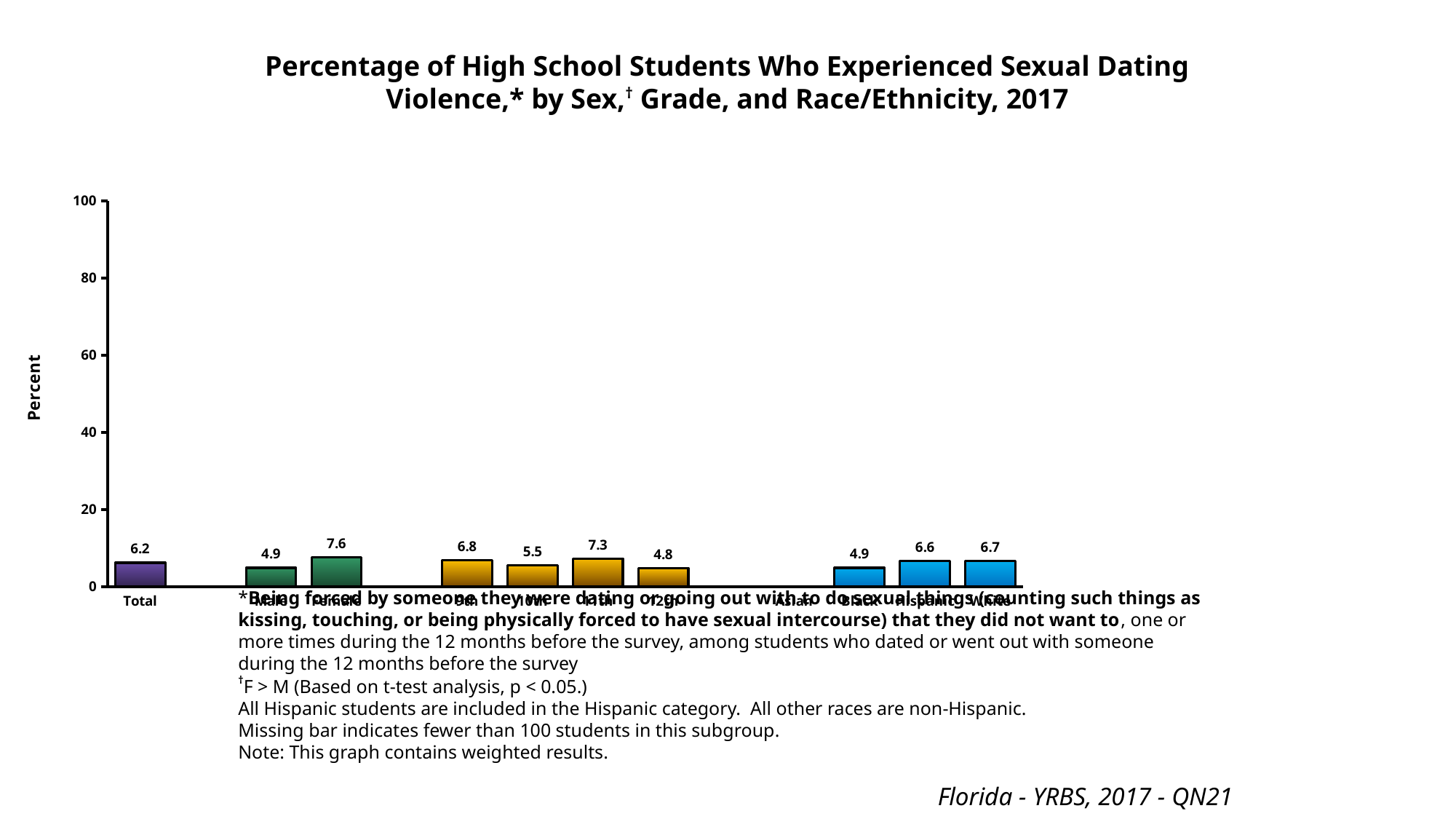
What is the highest value labelled on any bar in the chart? 7.6 What is the lowest value labelled on any bar in the chart? 4.8 What kind of chart is shown on the slide? bar chart What is the label on the vertical axis? Percent What is the difference between the Total value and the lowest labelled bar value (4.8)? 1.4 In the group of two bars immediately to the right of the Total bar, what is the value of the taller bar? 7.6 How many bars are plotted in the chart? 10 What is the difference between the highest labelled bar value (7.6) and the lowest labelled bar value (4.8)? 2.8 Is the value for Total greater or less than 10? less Is the value for Total greater or less than 20? less What is the value shown for the Total bar? 6.2 What is the maximum value shown on the vertical axis? 100